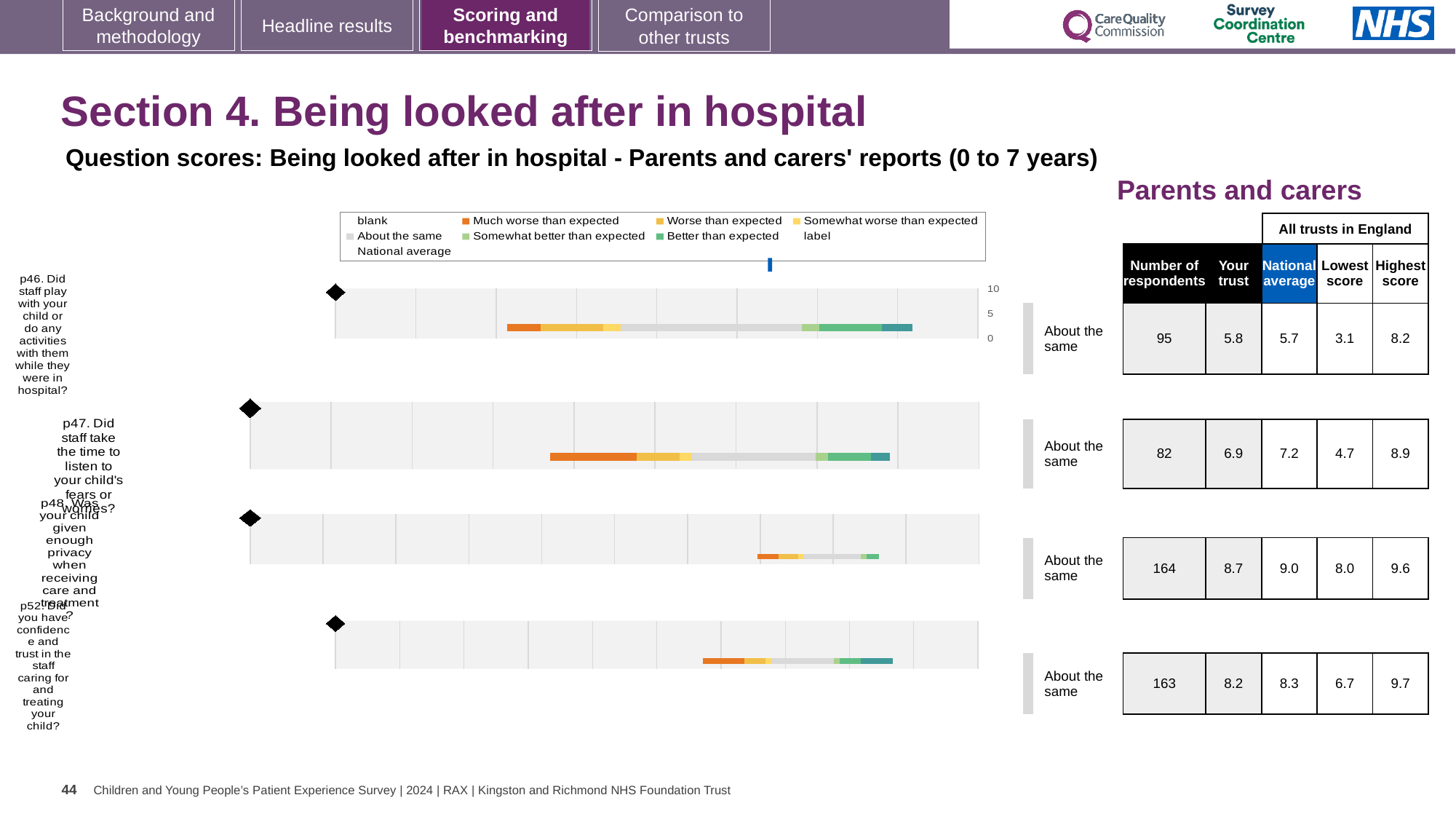
How many questions (p46, p47, p48, p52) have a benchmarking bar chart on this slide? 4 Which of the four questions has the highest 'Your trust' score in the table? p48 According to the table next to the charts, what is the 'Your trust' score for p46 (Did staff play with your child or do any activities with them while they were in hospital)? 5.8 What is the difference between the highest score (8.9) and the lowest score (4.7) for p47 in the table? 4.2 What kind of chart is used to show the question scores on this slide? bar chart What is the highest value shown on the axis of the p46 chart? 10 According to the table, how many respondents answered p48 (Was your child given enough privacy when receiving care and treatment)? 164 According to the table, what is the highest score among all trusts in England for p52 (Did you have confidence and trust in the staff caring for and treating your child)? 9.7 Which colour in the legend represents 'Much worse than expected'? orange Which of the four questions has the lowest 'Your trust' score in the table? p46 Is the 'Your trust' score for p47 larger or smaller than the national average for p47? smaller According to the table next to the charts, what is the national average for p47 (Did staff take the time to listen to your child's fears or worries)? 7.2